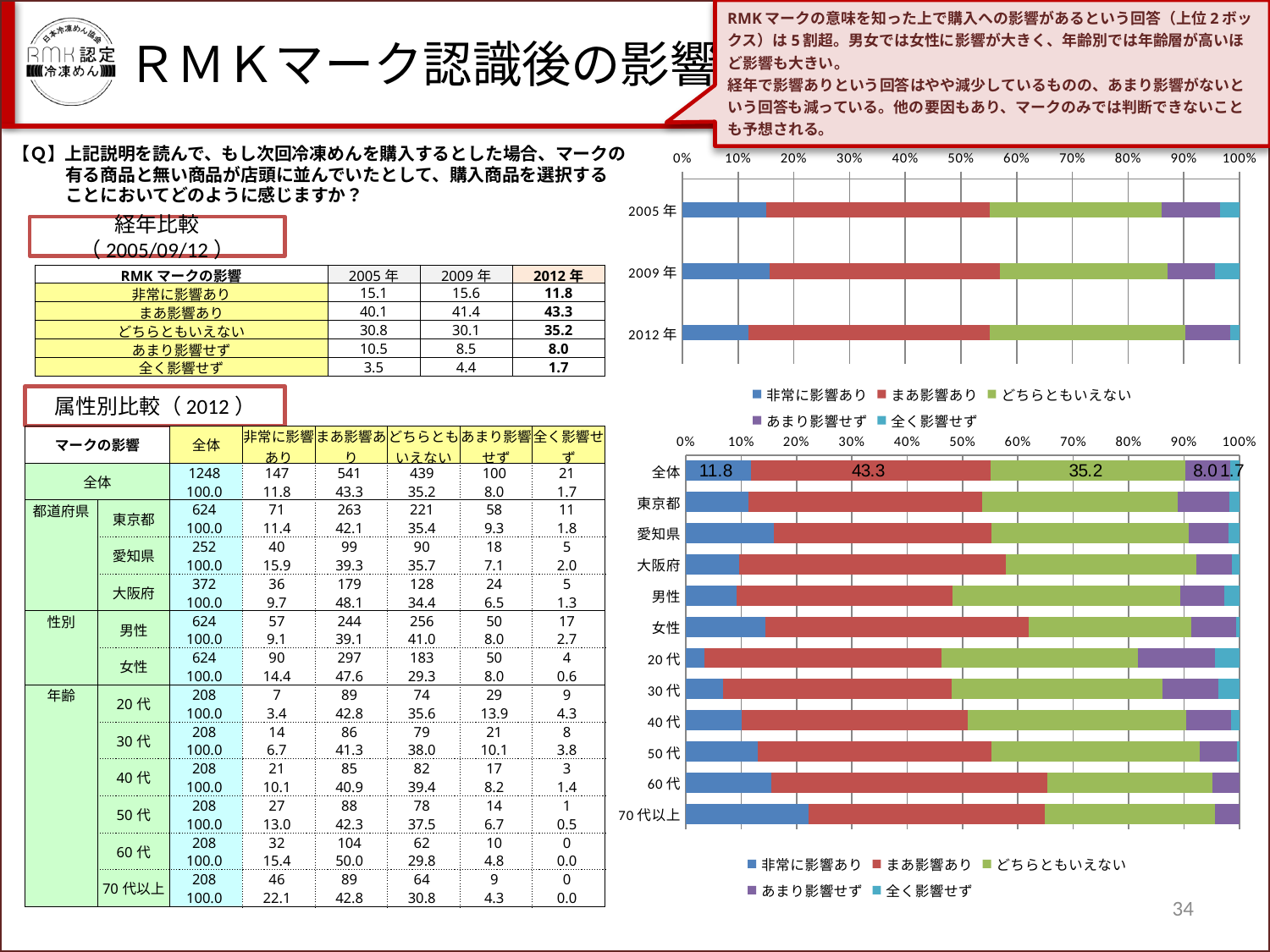
In the lower chart, what is the value of まあ影響あり for 全体? 43.3 In the lower chart, which series is shown in blue according to the legend? 非常に影響あり In the lower chart, what is the total of the 全体 bar (11.8 + 43.3 + 35.2 + 8.0 + 1.7)? 100.0 How many categories (bars) are shown in the lower chart (属性別比較)? 12 How many series does the legend of the lower chart list? 5 In the lower chart, which category has the longest 非常に影響あり segment? 70代以上 In the lower chart, what is the difference between まあ影響あり (43.3) and どちらともいえない (35.2) for 全体? 8.1 How many categories (bars) are shown in the upper chart with the years? 3 In the lower chart, what is the value of どちらともいえない for 全体? 35.2 In the upper chart, which year has the larger 非常に影響あり segment, 2009年 or 2012年? 2009年 What kind of chart is the lower chart (属性別比較)? Stacked bar chart In the lower chart, is the 非常に影響あり value for 20代 greater or less than 10%? less